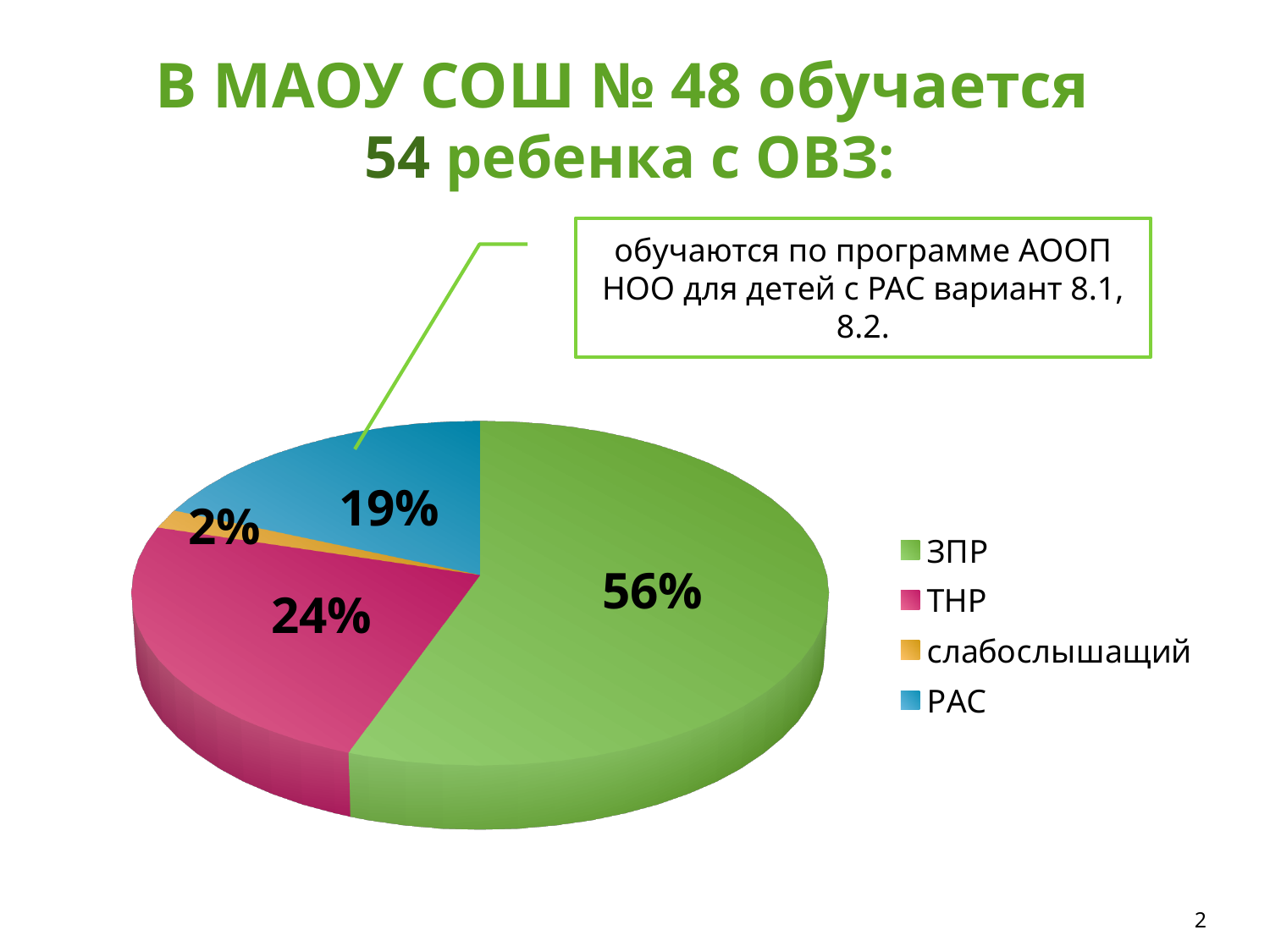
What is the difference in percentage points between the ЗПР and ТНР slices? 32 What share of the pie does слабослышащий have? 2% What kind of chart is shown on the slide? pie chart According to the slide title, how many children with ОВЗ study at МАОУ СОШ № 48? 54 What share of the pie does ЗПР have? 56% What colour is the ЗПР slice in the pie chart? green Which slice is larger, ТНР or РАС? ТНР Which category has the largest slice of the pie? ЗПР What share of the pie does ТНР have? 24% How many categories does the legend list? 4 Which category has the smallest slice of the pie? слабослышащий What share of the pie does РАС have? 19%